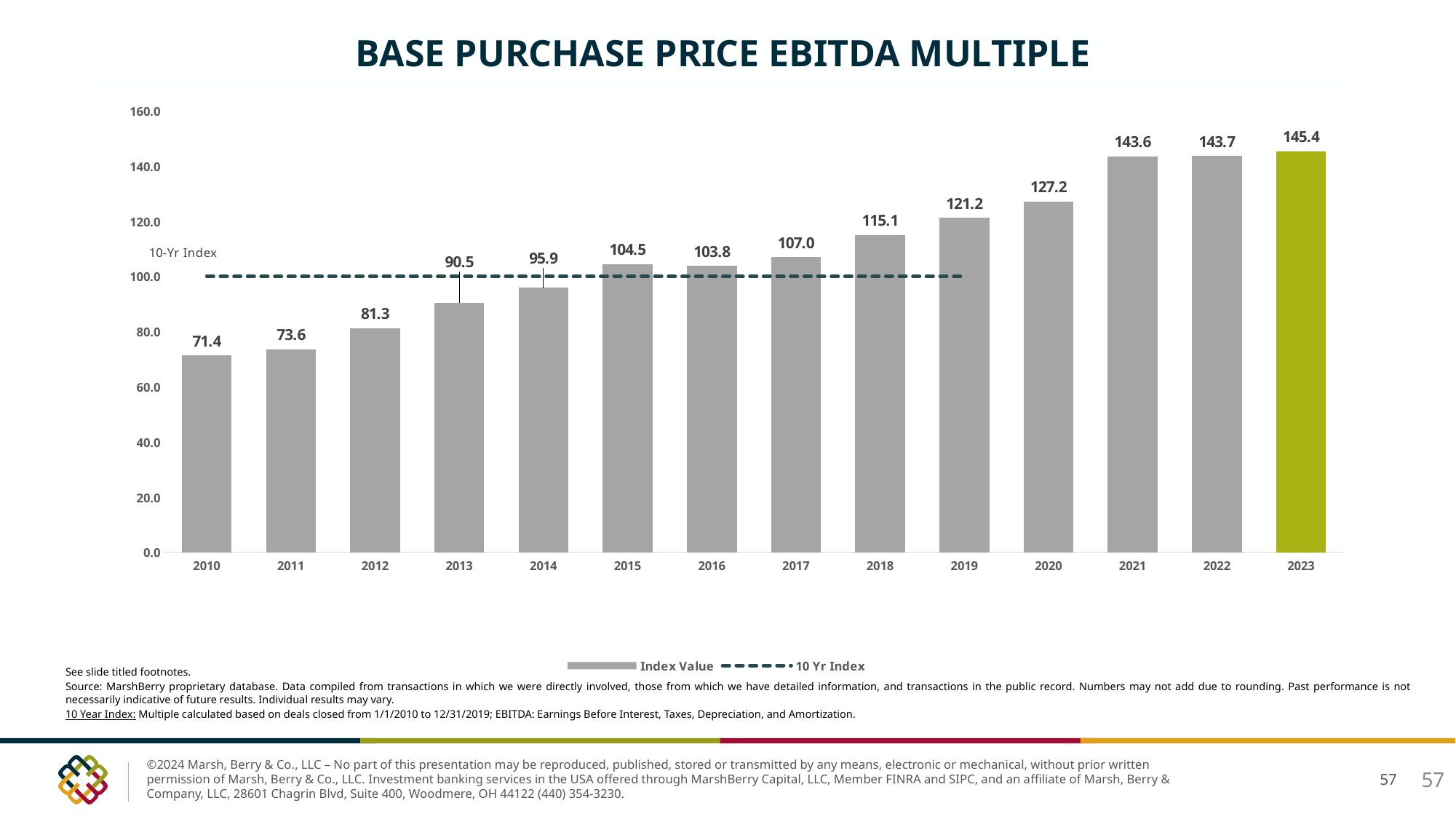
How many years are shown on the x axis? 14 What is the difference between the Index Value for 2023 and the Index Value for 2010? 74.0 Which year has the lowest Index Value? 2010 Is the Index Value for 2020 greater or less than 120.0? greater Which year has the highest Index Value? 2023 What is the Index Value for 2023? 145.4 How many series does the legend list? 2 What kind of chart is shown on the slide? Bar chart Which is larger, the Index Value for 2015 or the Index Value for 2016? 2015 What is the Index Value for 2016? 103.8 Do the Index Values generally rise or fall from 2010 to 2023? Rise What is the Index Value for 2010? 71.4